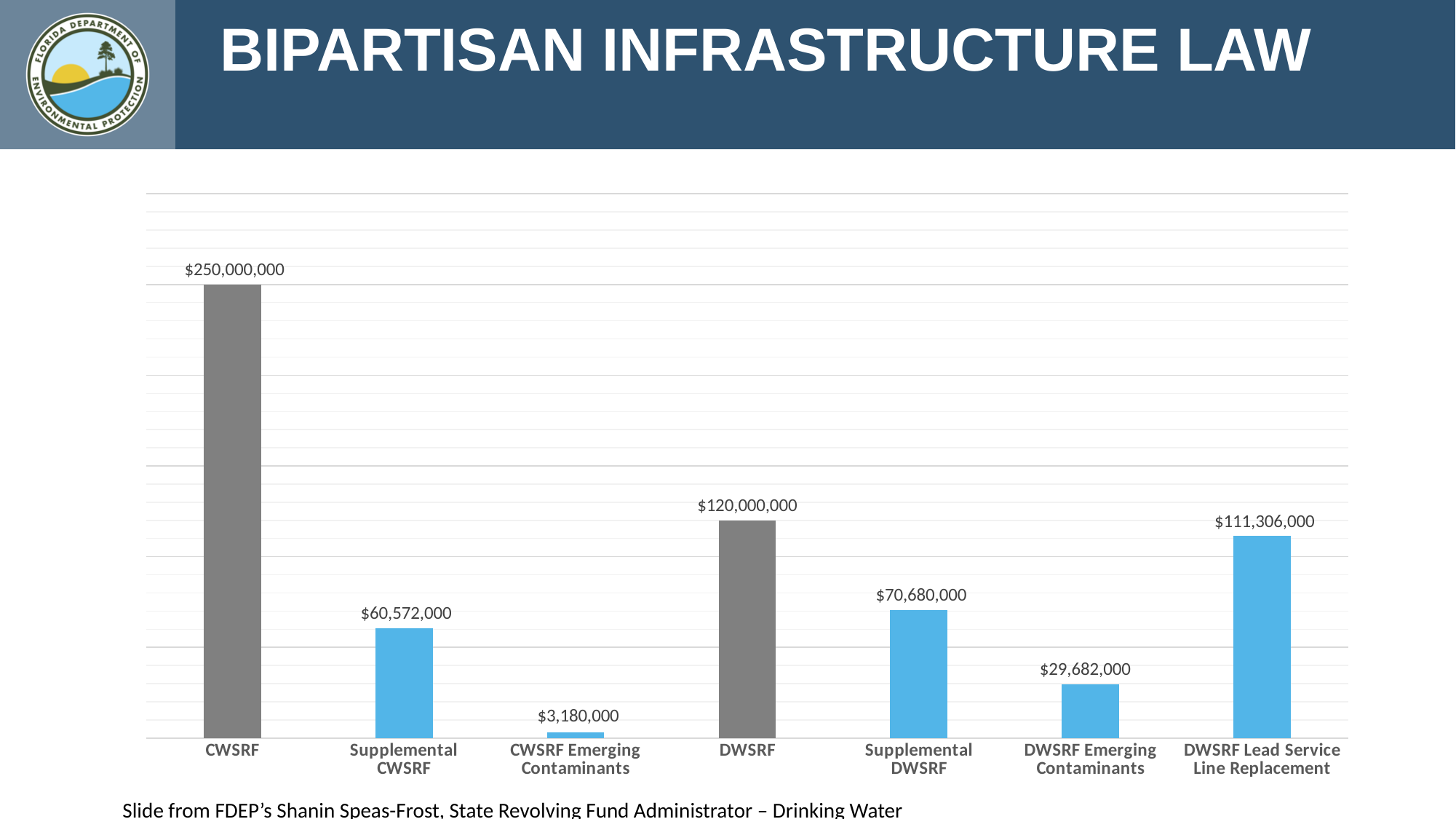
What is the value for CWSRF? $250,000,000 What kind of chart is shown on the slide? Bar chart Which category has the lowest value? CWSRF Emerging Contaminants Which two bars are colored gray rather than blue? CWSRF and DWSRF What is the value for DWSRF Lead Service Line Replacement? $111,306,000 What is the value for Supplemental DWSRF? $70,680,000 How many categories are shown on the chart? 7 Which is larger, DWSRF Emerging Contaminants or Supplemental CWSRF? Supplemental CWSRF What is the value for CWSRF Emerging Contaminants? $3,180,000 Which category has the highest value? CWSRF What is the difference between the Supplemental DWSRF and Supplemental CWSRF values? $10,108,000 What is the difference between the CWSRF and DWSRF values? $130,000,000